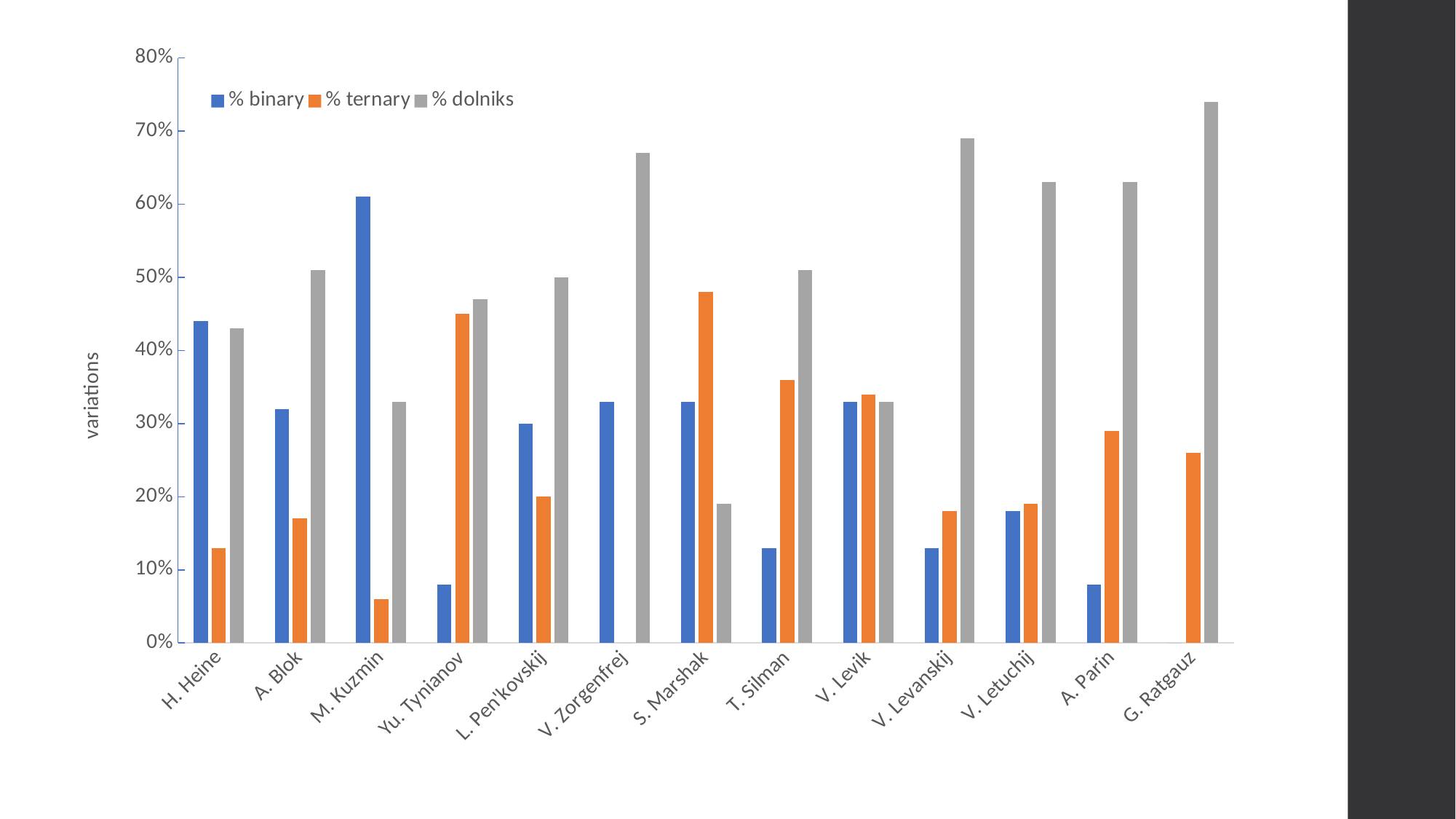
Is the % binary value for M. Kuzmin greater or less than 50%? greater Which poet has the lowest % dolniks value? S. Marshak For M. Kuzmin, which is larger: % binary or % dolniks? % binary How many poets (categories) are shown on the x axis? 13 Is the % dolniks value for V. Zorgenfrej greater or less than 60%? greater For H. Heine, which is larger: % binary or % ternary? % binary Which poet has the highest % dolniks value? G. Ratgauz Is the % dolniks value for S. Marshak greater or less than 30%? less What is the label on the vertical axis? variations Which poet has the highest % binary value? M. Kuzmin What kind of chart is shown on the slide? bar chart How many series does the legend list? 3